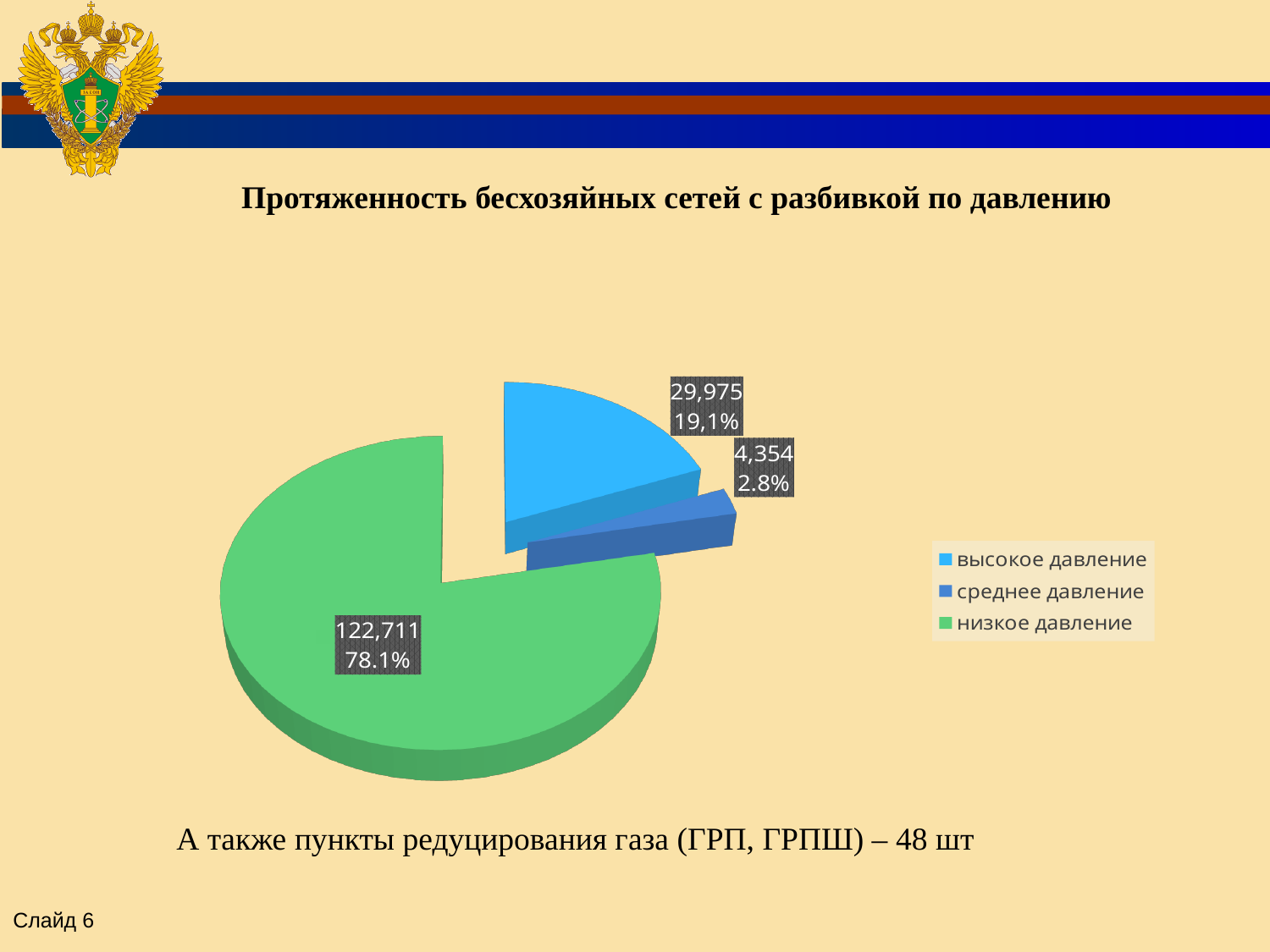
What is the value for низкое давление? 122,711 What share of the pie does среднее давление take? 2.8% Which category has the largest slice? низкое давление Which is larger, высокое давление or среднее давление? высокое давление What kind of chart is shown on the slide? pie chart Which category has the smallest slice? среднее давление How many categories does the legend list? 3 What share of the pie does низкое давление take? 78.1% What share of the pie does высокое давление take? 19,1% What is the value for среднее давление? 4,354 What is the difference between the values for низкое давление and высокое давление? 92,736 What is the value for высокое давление? 29,975